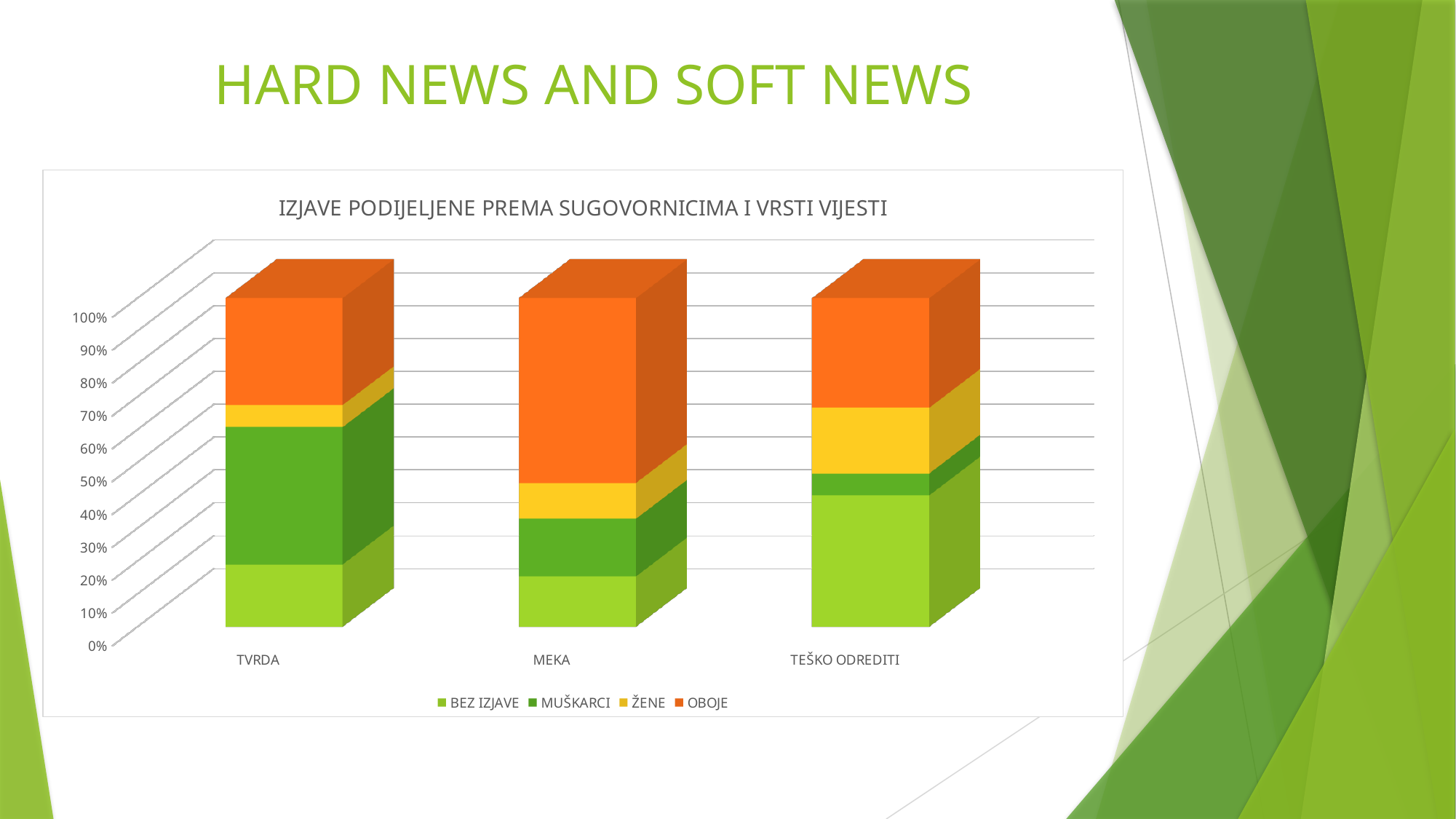
Which series is shown in orange in the chart? OBOJE Is the OBOJE share for MEKA greater or less than 50%? greater What is the title of the chart? IZJAVE PODIJELJENE PREMA SUGOVORNICIMA I VRSTI VIJESTI How many categories are shown on the x axis of the chart? 3 Which category has the largest OBOJE share? MEKA Is the MUŠKARCI share for TEŠKO ODREDITI greater or less than 20%? less Is the BEZ IZJAVE share for TEŠKO ODREDITI greater or less than 30%? greater What kind of chart is shown on the slide? Stacked bar chart Which category has the largest BEZ IZJAVE share? TEŠKO ODREDITI Which has the larger MUŠKARCI share, TVRDA or MEKA? TVRDA How many series does the chart legend list? 4